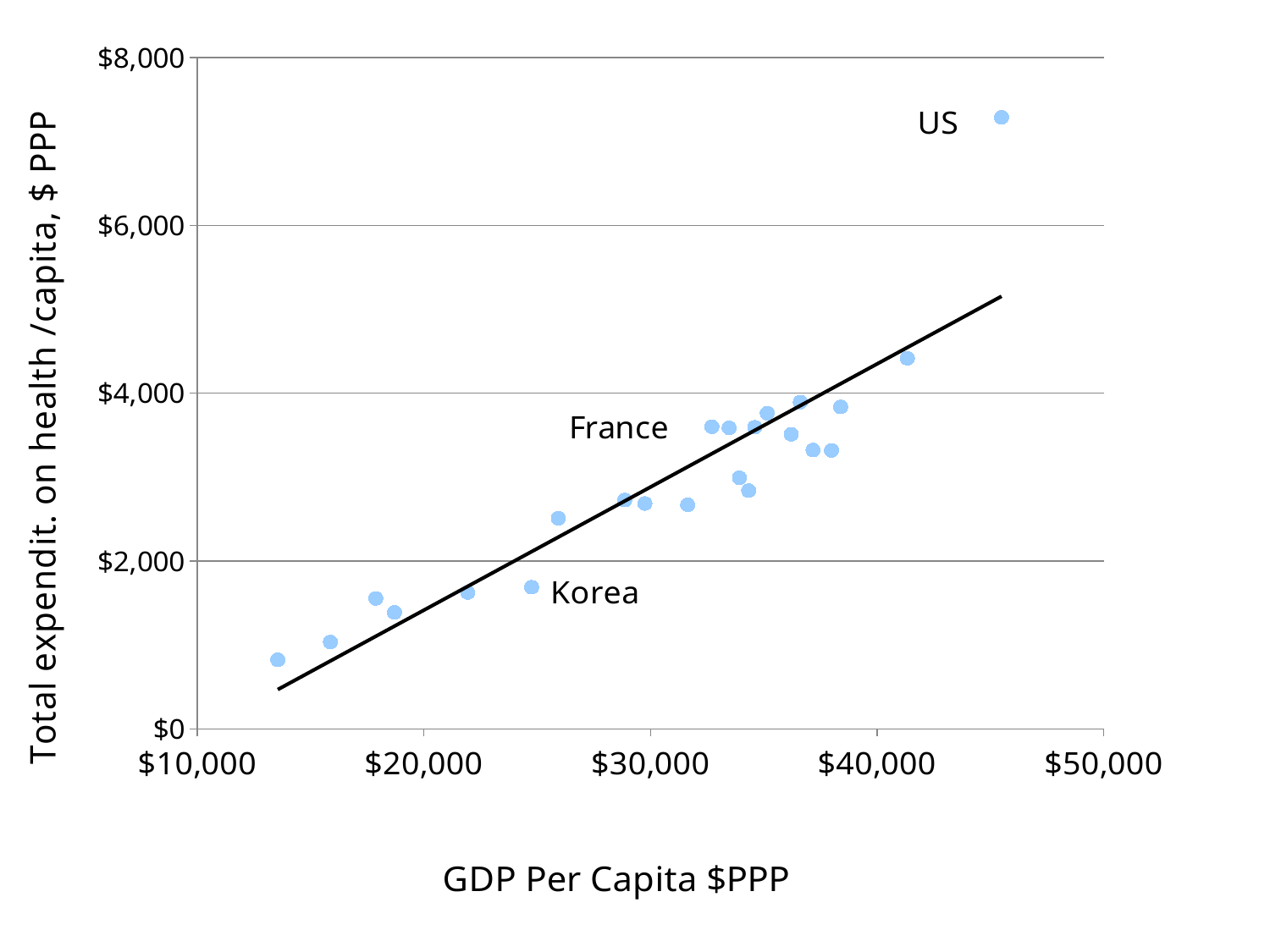
Is the total expenditure on health per capita for the US greater or less than $6,000? greater What kind of chart is shown on the slide? scatter plot Which has a higher total expenditure on health per capita, France or Korea? France What is the title of the y axis? Total expendit. on health /capita, $ PPP What is the title of the x axis? GDP Per Capita $PPP Is the GDP per capita for the US greater or less than $40,000? greater Which labelled country has the highest total expenditure on health per capita? US Do the plotted values generally rise or fall as GDP per capita increases? rise Is the total expenditure on health per capita for France greater or less than $2,000? greater Which has a higher total expenditure on health per capita, the US or France? US